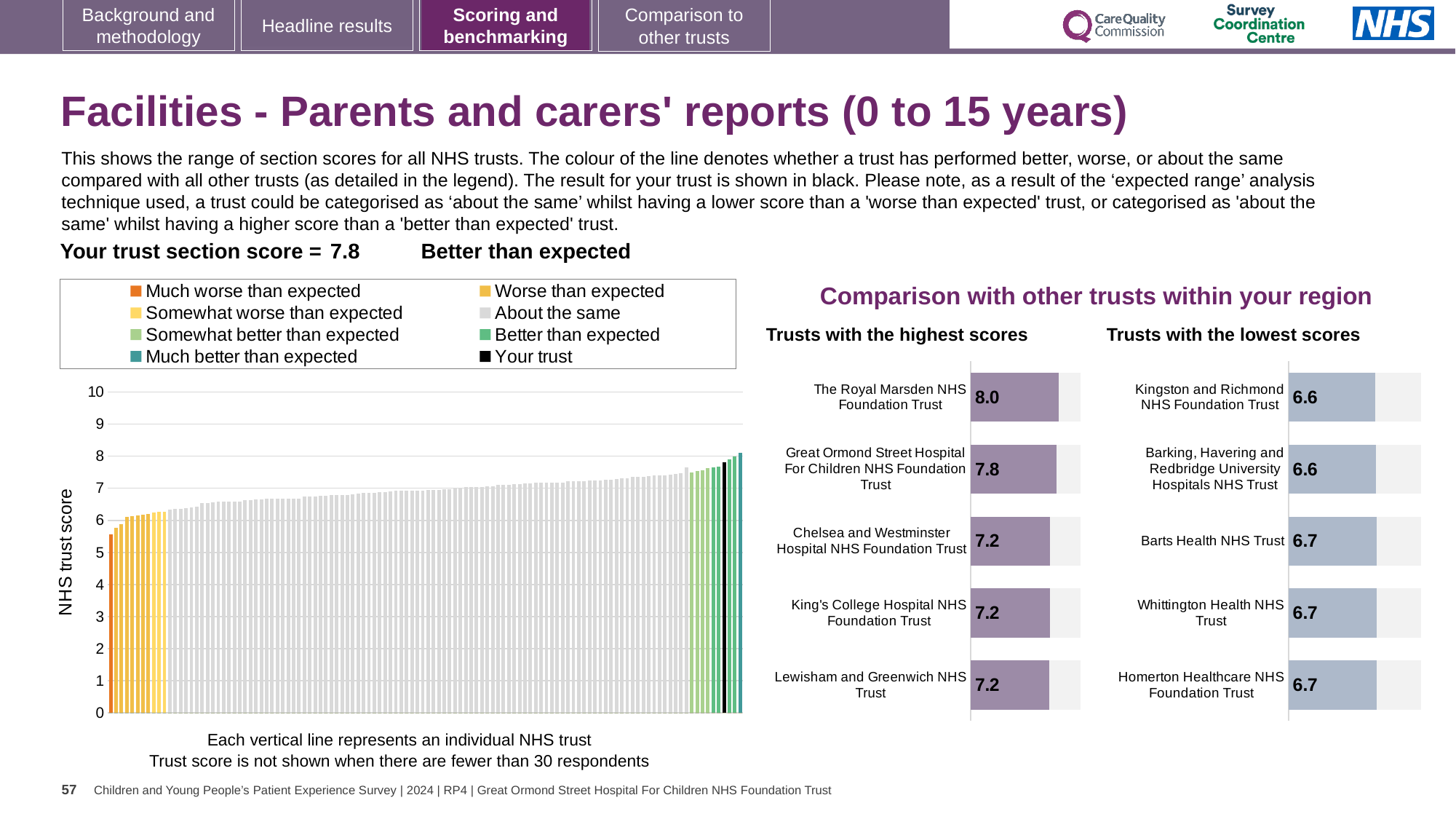
In the 'Trusts with the highest scores' chart, what is the score for The Royal Marsden NHS Foundation Trust? 8.0 In the large chart on the left, is the value of the lowest (orange) bar greater or less than 6? less In the 'Trusts with the lowest scores' chart, what is the difference between the scores of Whittington Health NHS Trust and Kingston and Richmond NHS Foundation Trust? 0.1 In the 'Trusts with the highest scores' chart, which trust has the highest score? The Royal Marsden NHS Foundation Trust In the 'Trusts with the highest scores' chart, what is the difference between the scores of The Royal Marsden NHS Foundation Trust and Great Ormond Street Hospital For Children NHS Foundation Trust? 0.2 In the 'Trusts with the highest scores' chart, what is the score for Great Ormond Street Hospital For Children NHS Foundation Trust? 7.8 In the 'Trusts with the lowest scores' chart, what is the score for Kingston and Richmond NHS Foundation Trust? 6.6 In the 'Trusts with the lowest scores' chart, what is the score for Barts Health NHS Trust? 6.7 What kind of chart is the large chart on the left showing NHS trust scores? Bar chart In the 'Trusts with the lowest scores' chart, which is larger: the score for Homerton Healthcare NHS Foundation Trust or Barking, Havering and Redbridge University Hospitals NHS Trust? Homerton Healthcare NHS Foundation Trust In the large chart on the left, how many entries does the legend list? 8 In the 'Trusts with the highest scores' chart, how many trusts are listed? 5